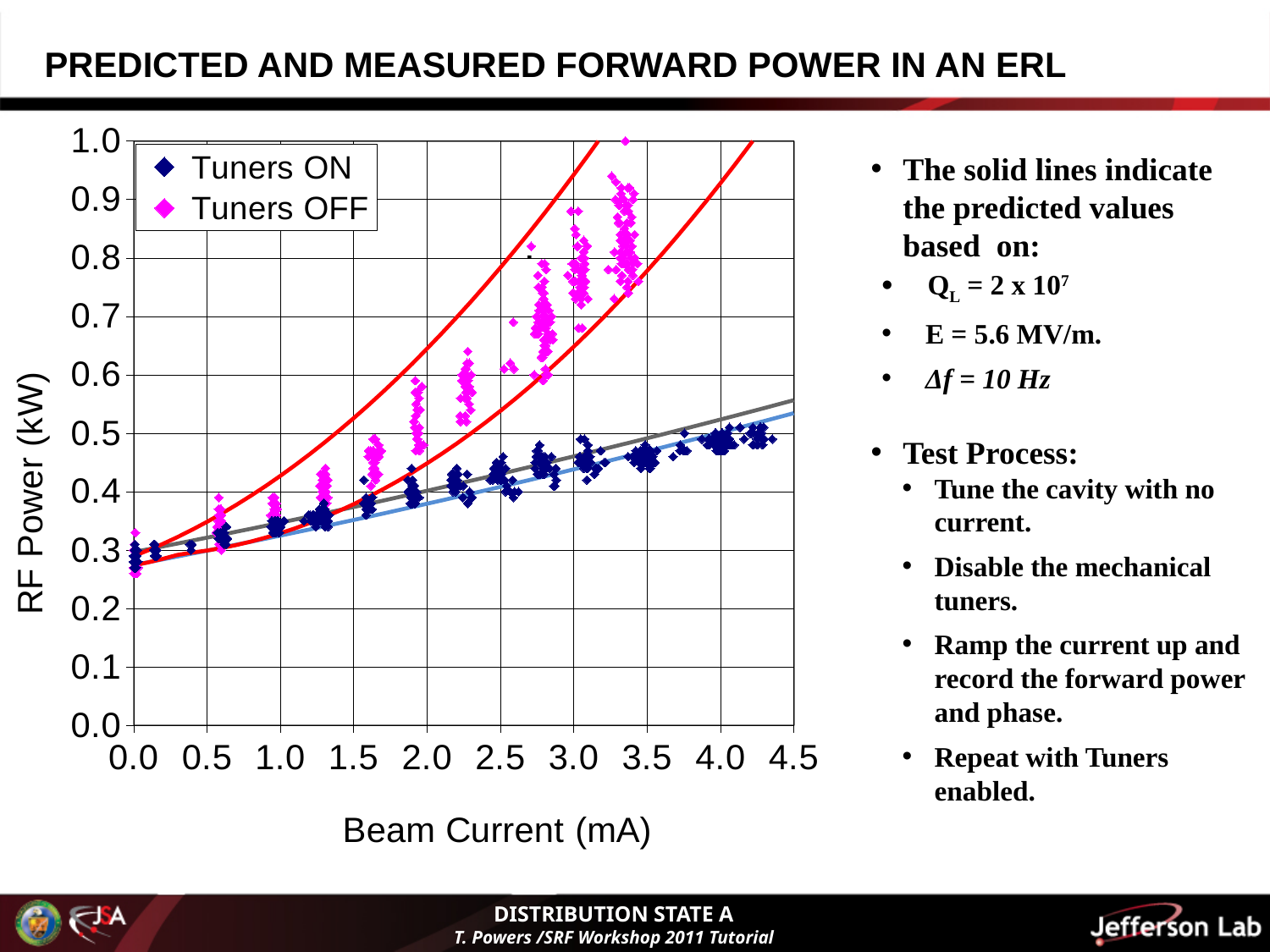
How many series does the chart legend list? 2 What are the two series named in the chart legend? Tuners ON and Tuners OFF Is the RF power for Tuners ON at about 4.0 mA greater or less than 0.6 kW? less What is the highest value shown on the y axis of the chart? 1.0 Do the Tuners OFF values rise or fall as beam current increases? rise At a beam current of about 3.3 mA, which series shows the higher RF power, Tuners ON or Tuners OFF? Tuners OFF Is the RF power for Tuners OFF at about 2.8 mA greater or less than 0.5 kW? greater Is the RF power for Tuners ON at 0.0 mA greater or less than 0.4 kW? less What is the label of the x axis of the chart? Beam Current (mA) What kind of chart is shown on the slide? scatter chart Do the Tuners ON values rise or fall as beam current increases? rise